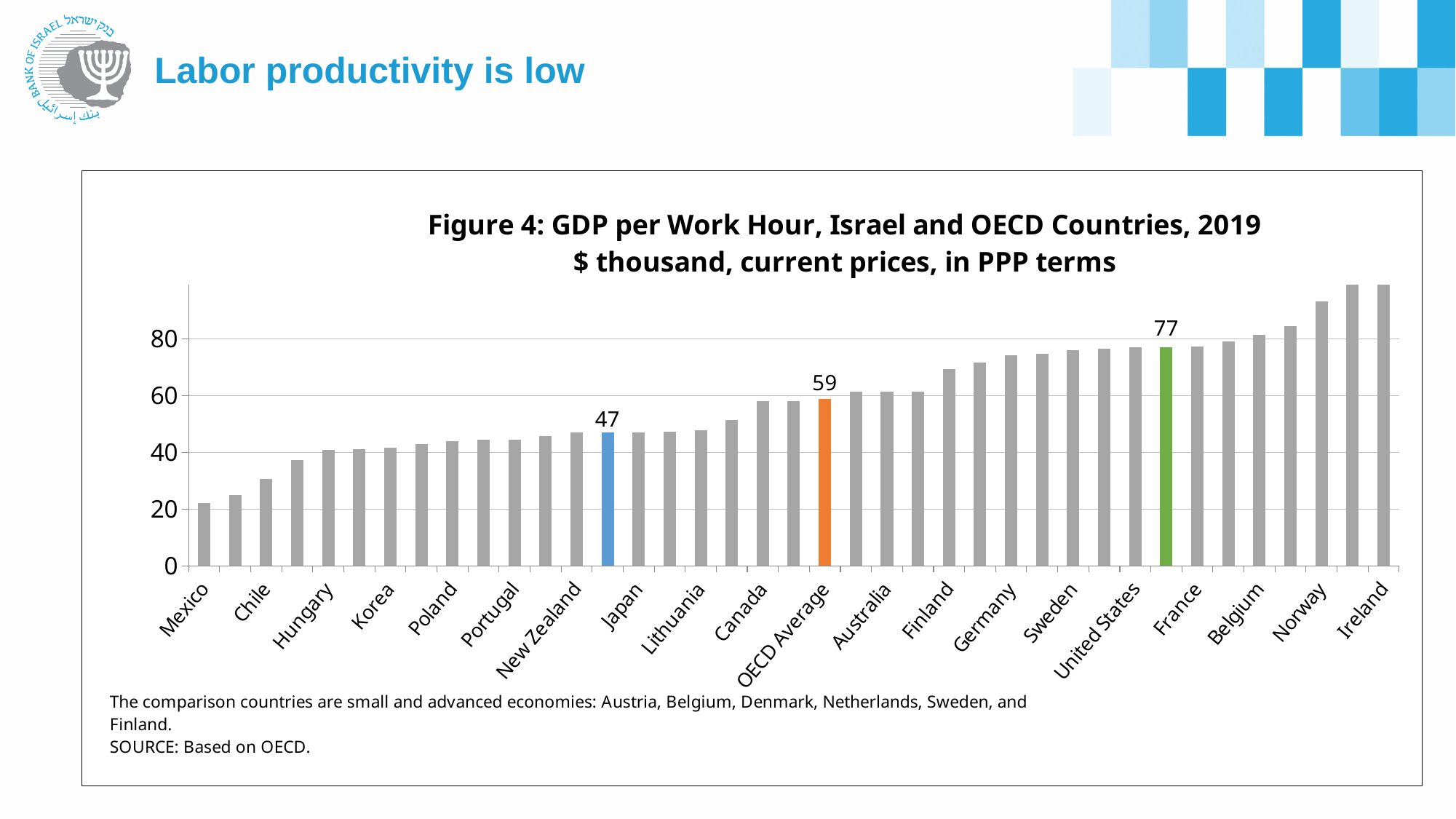
Which has a higher GDP per work hour, Canada or Australia? Australia What value is labeled on the green bar? 77 Which labeled country has the lowest GDP per work hour? Mexico What is the difference between the OECD Average (59) and the value labeled on the blue bar (47)? 12 What is the difference between the value labeled on the green bar (77) and the OECD Average (59)? 18 What colour is the OECD Average bar? orange What value is labeled on the blue bar? 47 Is the value for Norway greater or less than 80? greater Do the bar values rise or fall moving from left to right along the x axis? rise What is the value for OECD Average? 59 What kind of chart is shown on the slide? bar chart Is the value for Mexico greater or less than 40? less